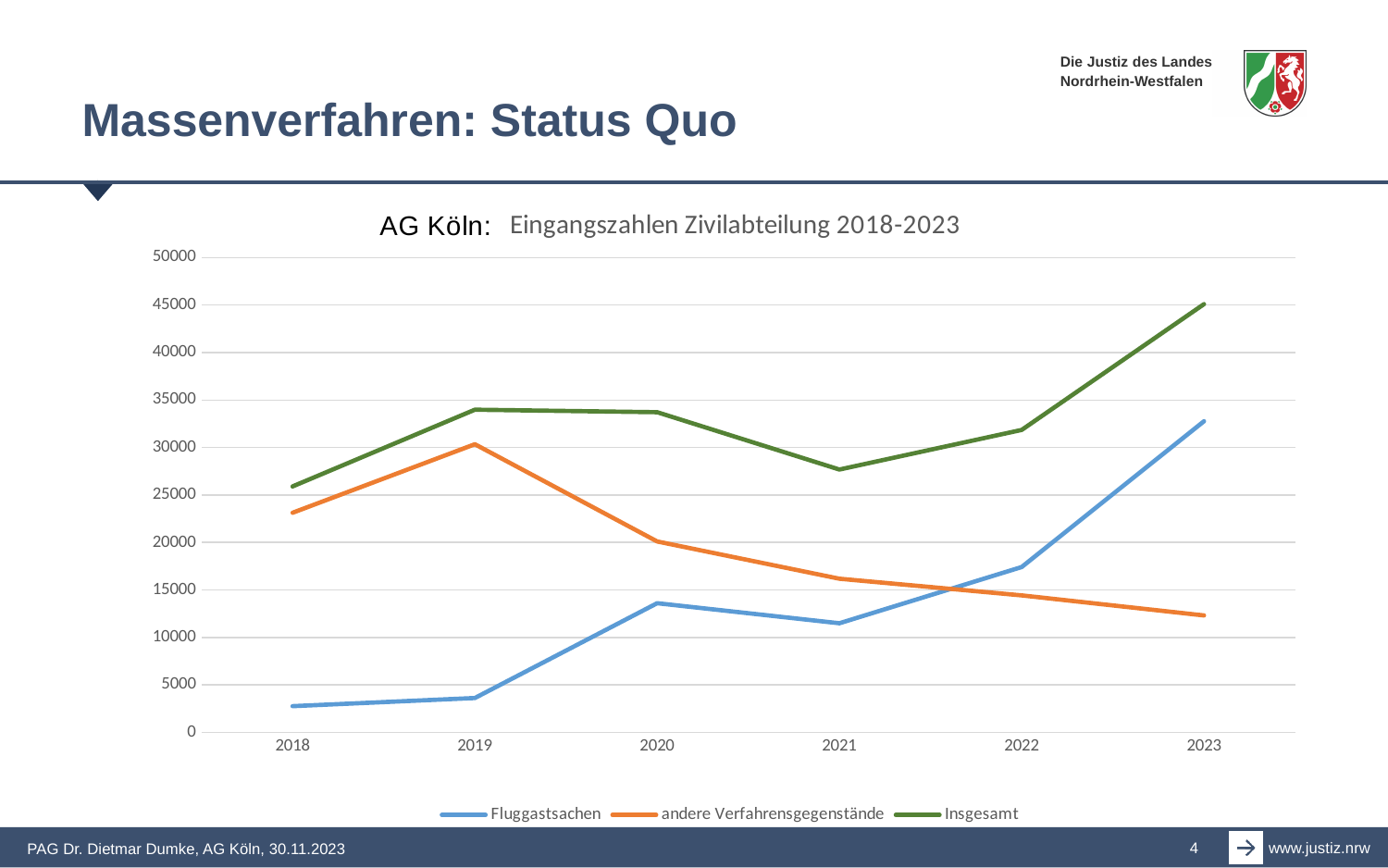
In 2023, which is larger: Fluggastsachen or andere Verfahrensgegenstände? Fluggastsachen Is the value for andere Verfahrensgegenstände in 2023 greater or less than 15000? less In which year is the Fluggastsachen value lowest? 2018 How many series does the legend list? 3 In which year is the value for andere Verfahrensgegenstände highest? 2019 Is the Insgesamt value for 2023 greater or less than 40000? greater How many years are plotted along the x axis? 6 In which year is the Insgesamt value highest? 2023 What is the title of the chart? AG Köln: Eingangszahlen Zivilabteilung 2018-2023 Do the values for andere Verfahrensgegenstände rise or fall from 2019 to 2023? fall Is the Fluggastsachen value for 2018 greater or less than 5000? less What kind of chart is shown on the slide? line chart